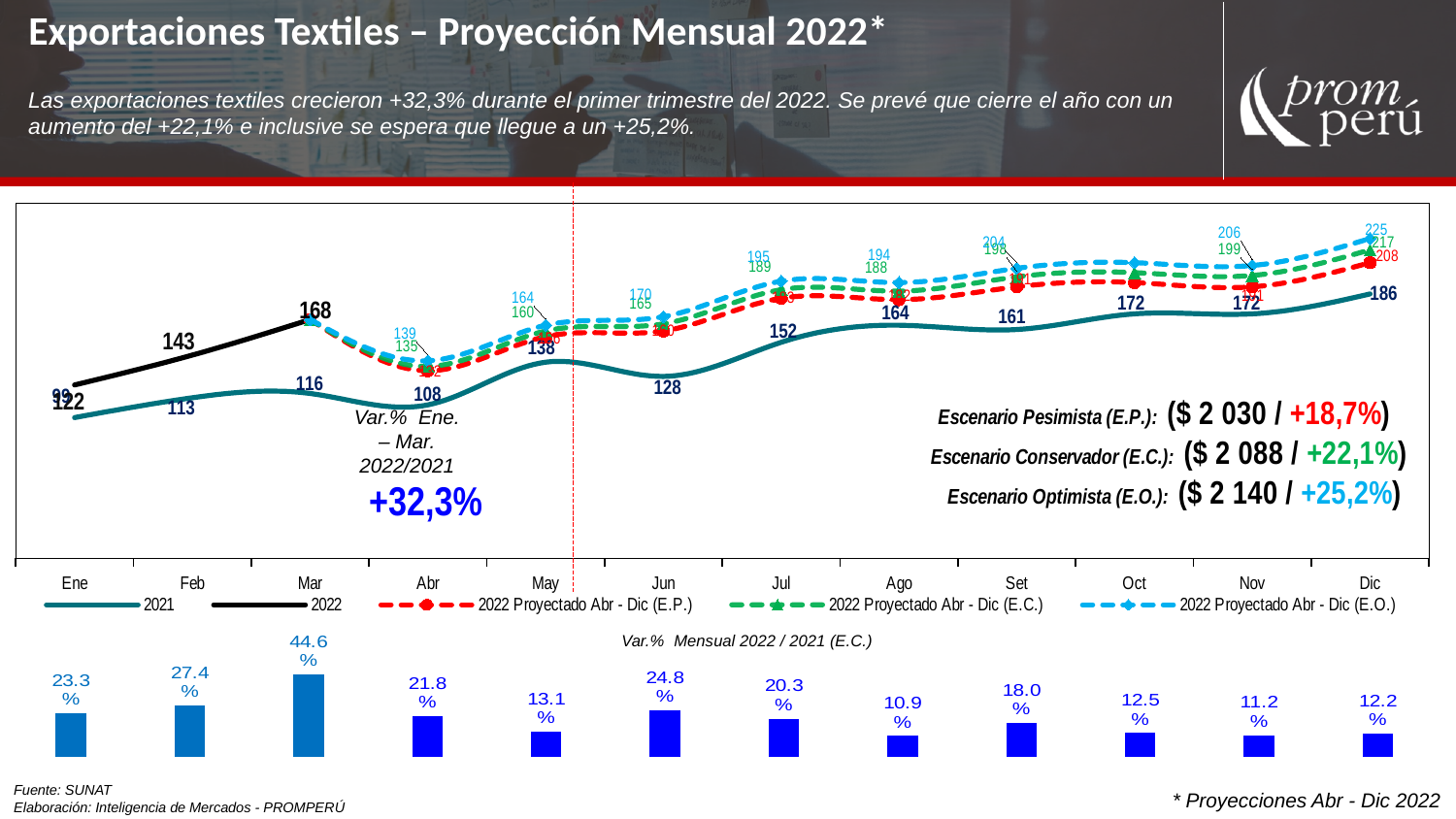
In the top line chart, what is the difference between the 2022 value and the 2021 value for Mar? 52 How many series does the legend of the top line chart list? 5 What kind of chart is the bottom chart (Var.% Mensual 2022 / 2021 (E.C.))? Bar chart In the bottom bar chart (Var.% Mensual 2022 / 2021 (E.C.)), what is the difference between the values for Feb and Ene? 4.1 percentage points How many bars are shown in the bottom bar chart (Var.% Mensual 2022 / 2021 (E.C.))? 12 In the top line chart, what is the 2021 value for Jul? 152 In the bottom bar chart (Var.% Mensual 2022 / 2021 (E.C.)), what is the value for Jun? 24.8% In the top line chart, what is the 2022 value for Mar? 168 In the top line chart, which is larger for Feb: the 2021 value or the 2022 value? 2022 (143) In the bottom bar chart (Var.% Mensual 2022 / 2021 (E.C.)), which month has the highest value? Mar (44.6%) In the top line chart, what is the 2021 value for Dic? 186 In the bottom bar chart (Var.% Mensual 2022 / 2021 (E.C.)), which month has the lowest value? Ago (10.9%)